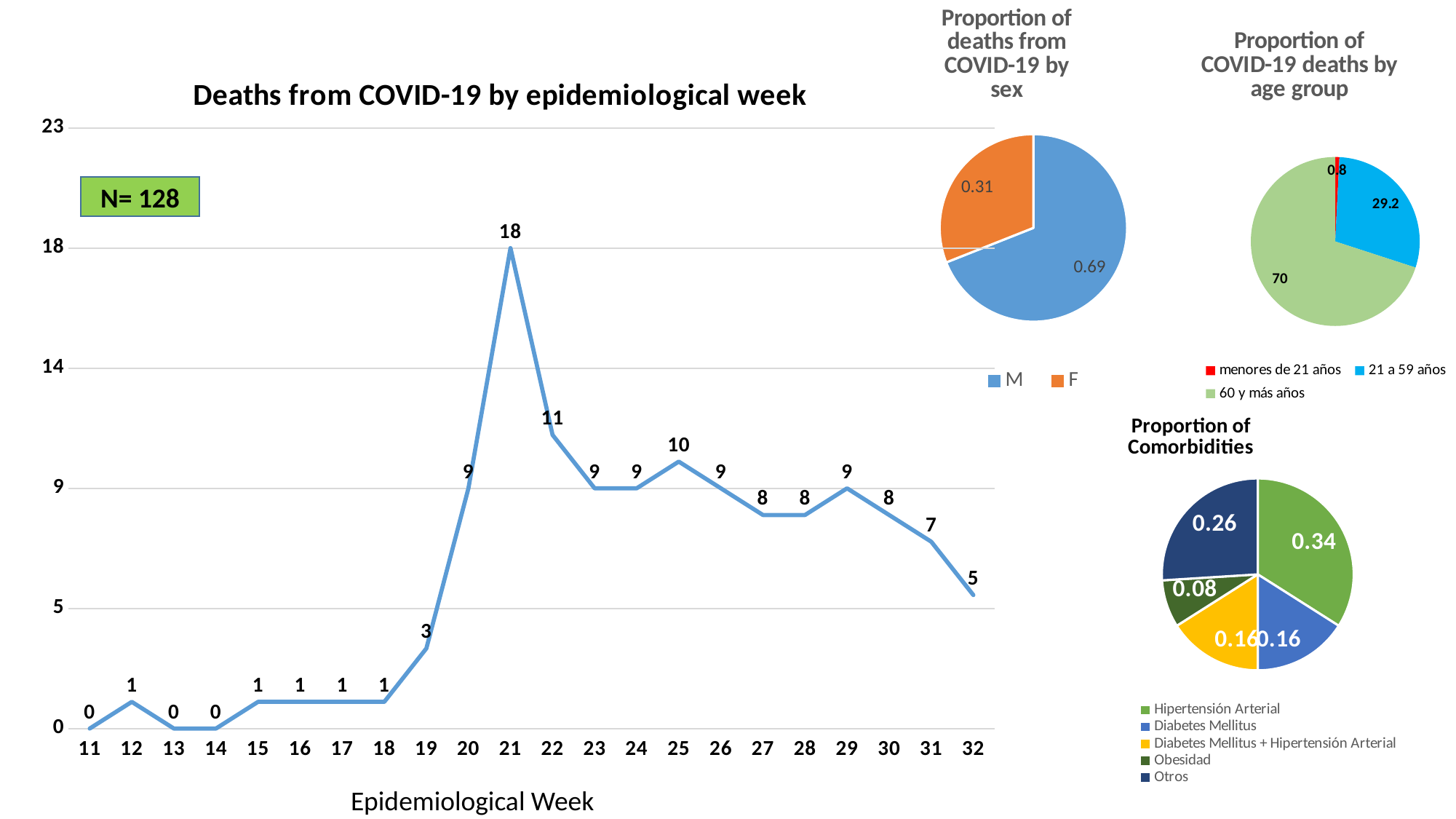
How many categories does the legend of the 'Proportion of Comorbidities' pie chart list? 5 In the 'Proportion of deaths from COVID-19 by sex' pie chart, what is the proportion for M? 0.69 In the 'Deaths from COVID-19 by epidemiological week' chart, which epidemiological week has the highest number of deaths? 21 In the 'Proportion of COVID-19 deaths by age group' pie chart, what is the value for '60 y más años'? 70 In the 'Deaths from COVID-19 by epidemiological week' chart, do the values rise or fall from week 29 to week 32? Fall In the 'Proportion of Comorbidities' pie chart, which category has the smallest share? Obesidad In the 'Deaths from COVID-19 by epidemiological week' chart, how many deaths were recorded in week 21? 18 In the 'Deaths from COVID-19 by epidemiological week' chart, how many deaths were recorded in week 32? 5 In the 'Deaths from COVID-19 by epidemiological week' chart, how many epidemiological weeks are plotted on the x axis? 22 In the 'Deaths from COVID-19 by epidemiological week' chart, what is the difference in deaths between week 21 and week 22? 7 What type of chart is 'Deaths from COVID-19 by epidemiological week'? Line chart In the 'Proportion of deaths from COVID-19 by sex' pie chart, which category has the larger share, M or F? M